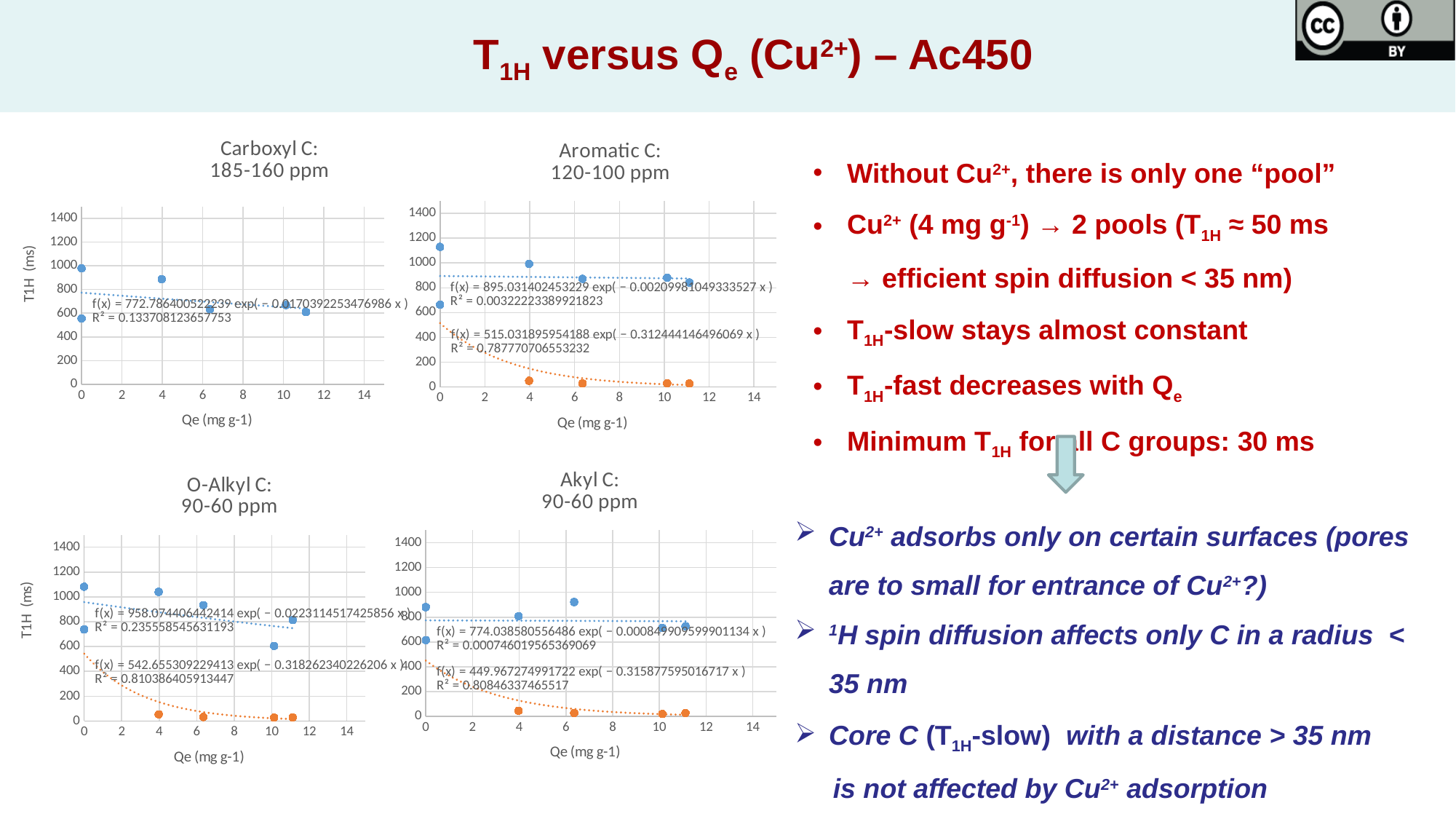
In the Akyl C chart, is the blue point at Qe = 6 greater or less than 1000? less What kind of chart is the Carboxyl C chart? Scatter chart In the Carboxyl C chart, is the point at Qe = 4 greater or less than 800? greater In the Akyl C chart, do the orange points rise or fall as Qe increases? fall In the O-Alkyl C chart, is the blue point at Qe = 10 greater or less than 800? less What R² value is shown for the orange trendline in the O-Alkyl C chart? 0.810386405913447 How many charts are shown on the slide? 4 What is the label of the x axis on the Aromatic C chart? Qe (mg g-1) What is the highest tick value on the y axis of the O-Alkyl C chart? 1400 What R² value is shown for the blue trendline in the Carboxyl C chart? 0.133708123657753